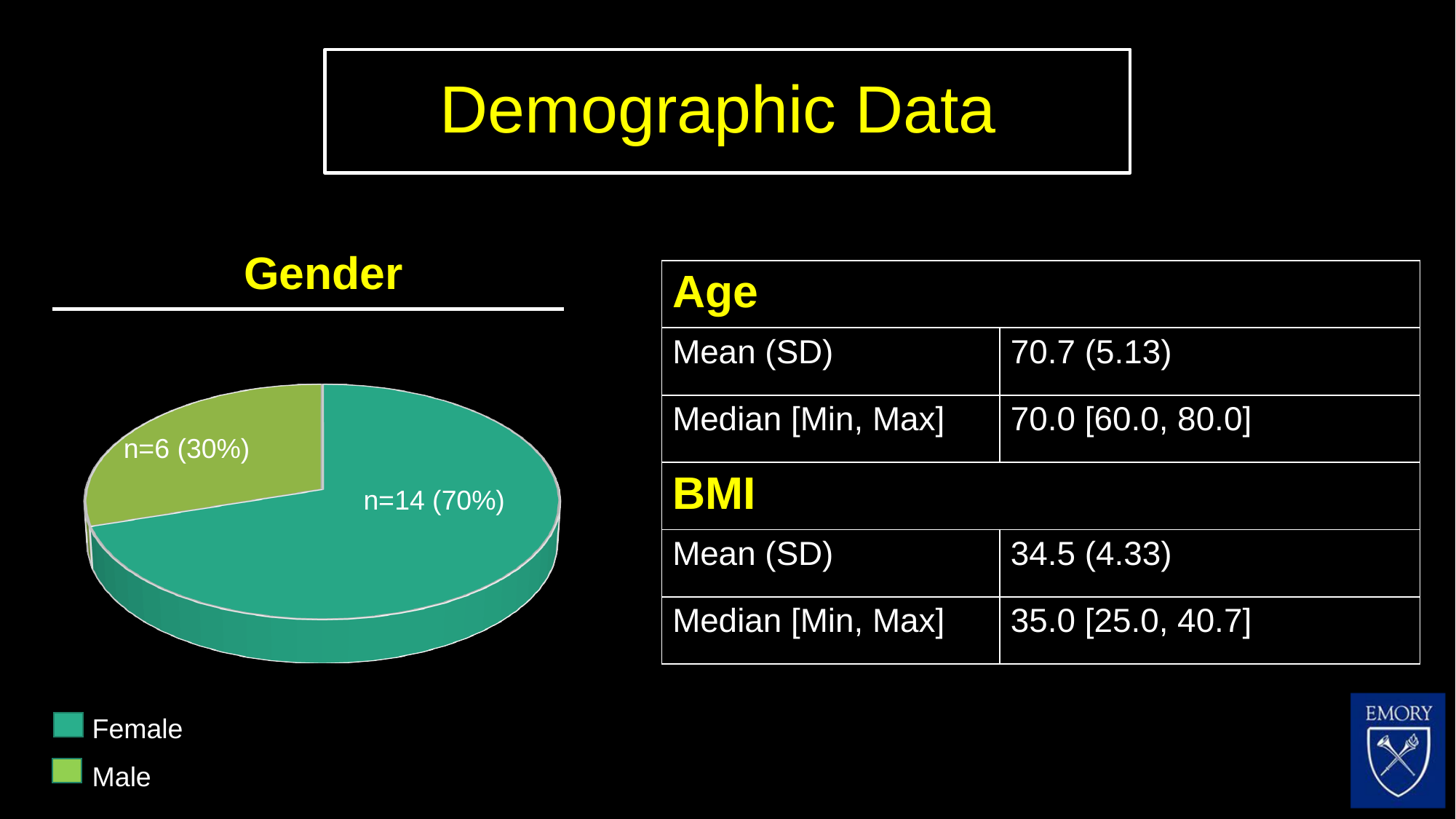
How many entries does the legend of the Gender chart list? 2 How many slices does the Gender pie chart have? 2 What is the count (n) for Male in the Gender chart? n=6 What is the total number of participants shown in the Gender pie chart? 20 What is the count (n) for Female in the Gender chart? n=14 What share of the Gender pie does the Male slice represent? 30% Which category has the largest slice in the Gender chart? Female In the Gender chart, how many more participants are Female than Male? 8 What share of the Gender pie does the Female slice represent? 70% Which category has the smallest slice in the Gender chart? Male What is the title of the chart on the slide? Gender What kind of chart is the Gender chart? pie chart